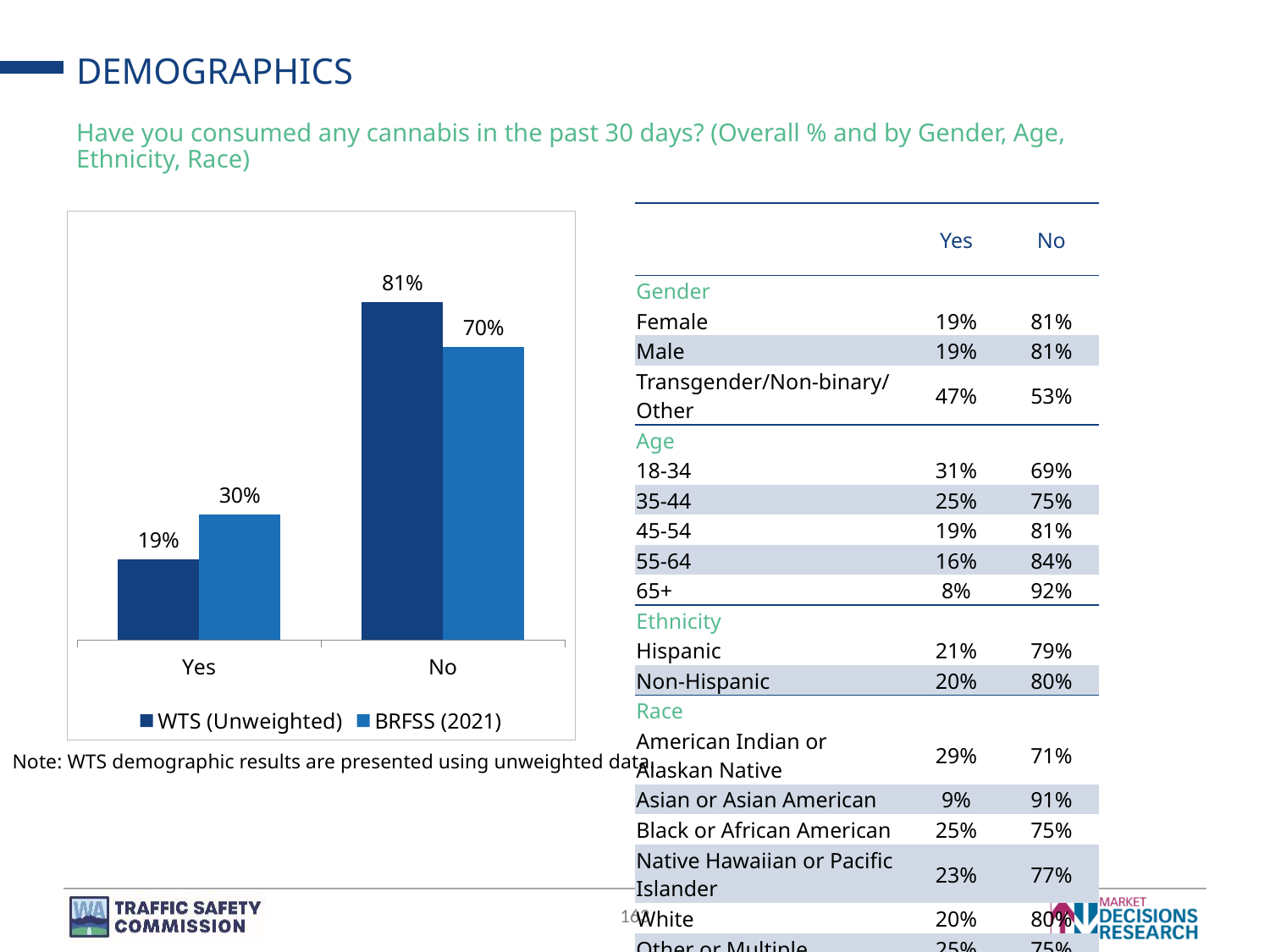
Which category has the lowest BRFSS (2021) value? Yes What is the difference between the WTS (Unweighted) and BRFSS (2021) values for No? 11% What is the BRFSS (2021) value for Yes? 30% How many series does the legend list? 2 What kind of chart is shown on the slide? bar chart How many categories are shown on the x axis? 2 What are the two series names listed in the legend? WTS (Unweighted) and BRFSS (2021) What is the WTS (Unweighted) value for No? 81% What is the BRFSS (2021) value for No? 70% For Yes, which series has the larger value, WTS (Unweighted) or BRFSS (2021)? BRFSS (2021) What is the WTS (Unweighted) value for Yes? 19% Which category has the highest WTS (Unweighted) value? No